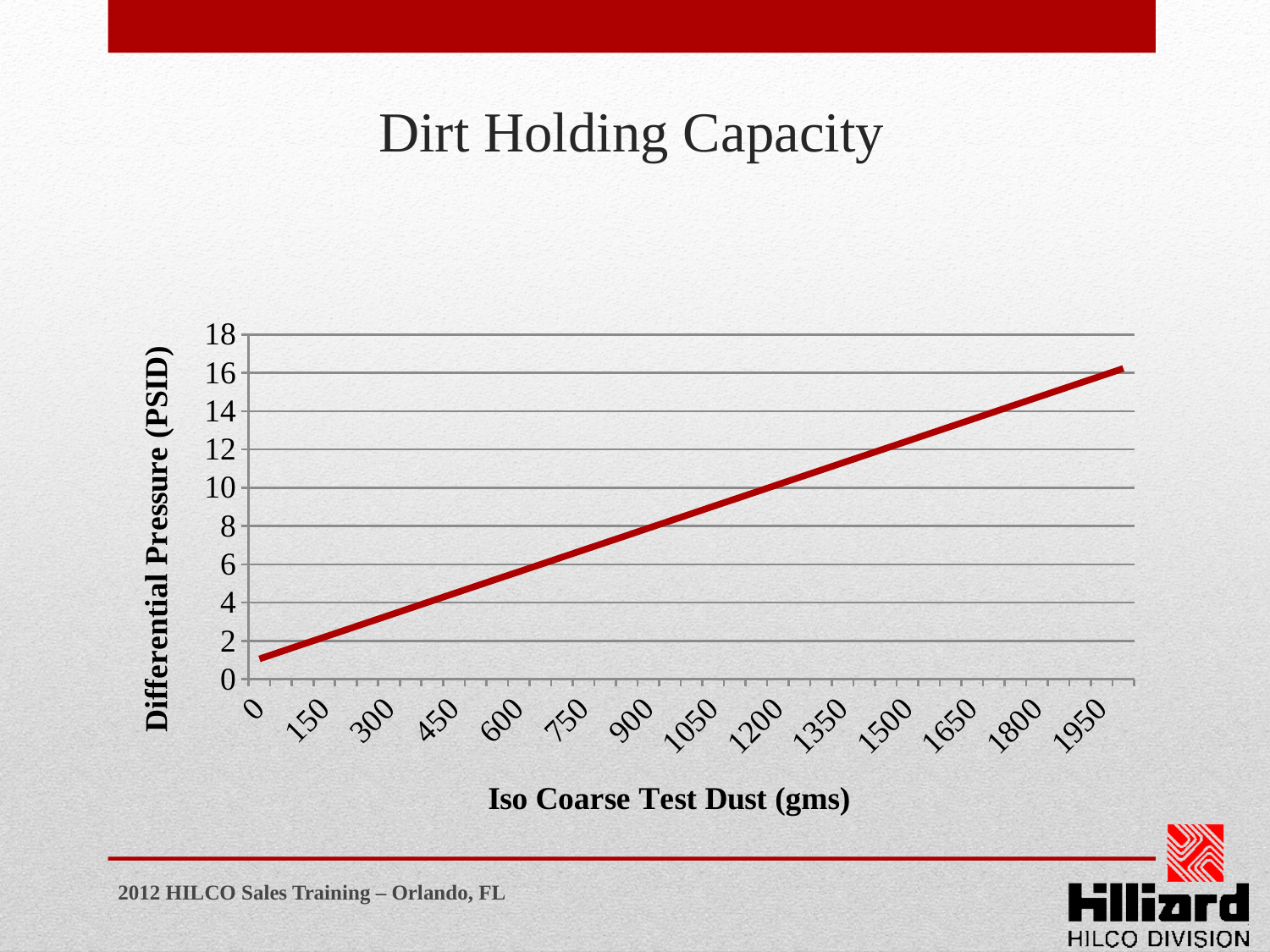
Is the differential pressure at 1950 gms greater or less than 18? less What is the label of the y axis? Differential Pressure (PSID) Which has the larger differential pressure, 300 gms or 1800 gms of test dust? 1800 gms At which end of the x axis is the differential pressure lowest? 0 gms Is the differential pressure at 0 gms greater or less than 2? less What is the title of the chart? Dirt Holding Capacity Does the differential pressure rise or fall as the Iso Coarse Test Dust increases along the x axis? rise What kind of chart is shown on the slide? line chart Is the differential pressure at 600 gms greater or less than 4? greater How many tick labels are shown on the x axis? 14